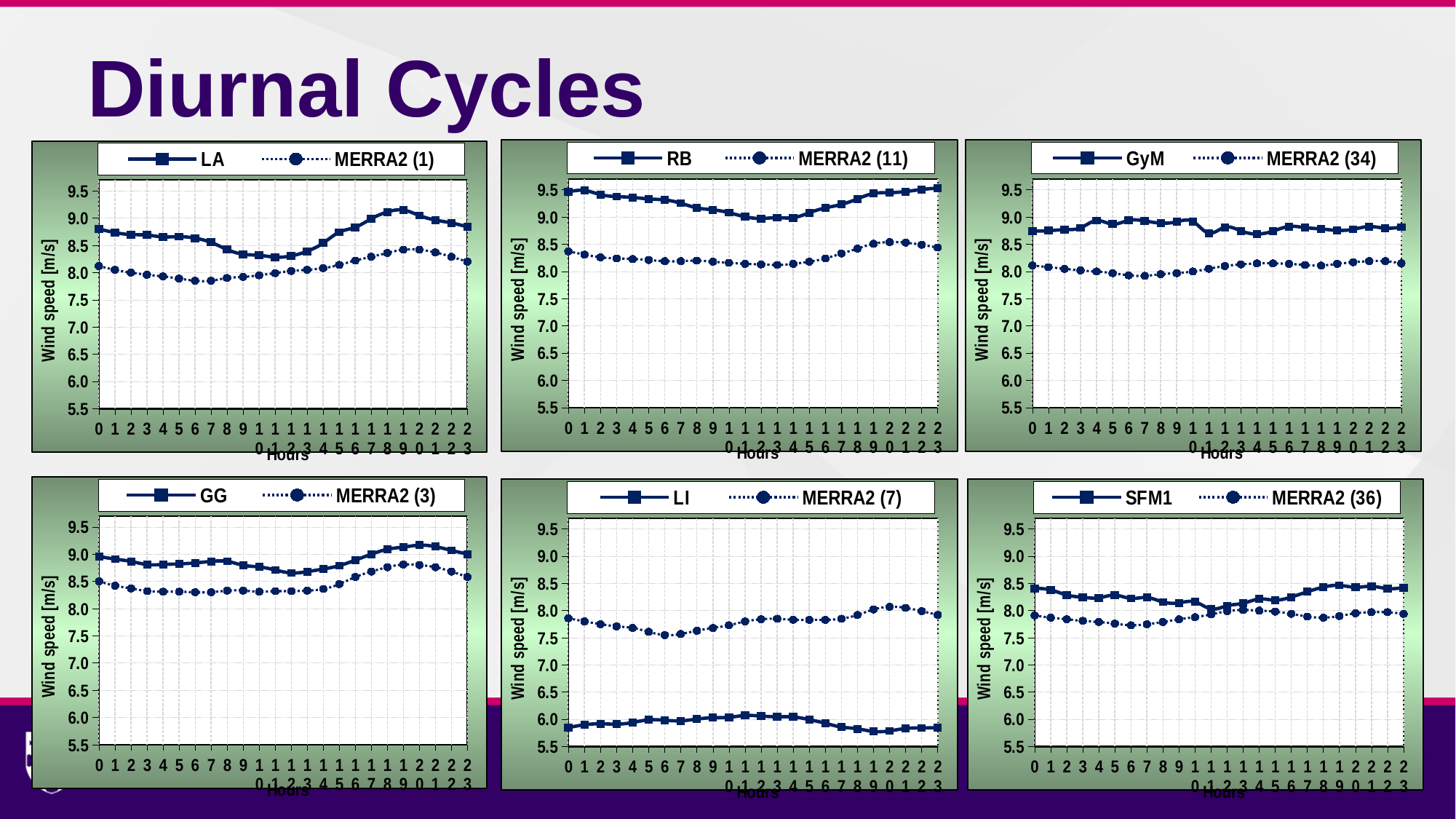
In the top-middle chart (RB), which series is higher at hour 12, RB or MERRA2 (11)? RB In the bottom-middle chart (LI), which series has the higher values across the day, LI or MERRA2 (7)? MERRA2 (7) How many series does the legend of the top-left chart (LA) list? 2 In the top-middle chart (RB), is the value for RB at hour 0 greater or less than 9.0? greater What are the two legend entries of the top-left chart? LA and MERRA2 (1) In the bottom-middle chart (LI), is the value for LI at hour 12 greater or less than 6.5? less How many hour points are plotted along the x axis of the bottom-left chart (GG)? 24 What is the y-axis label of the top-right chart (GyM)? Wind speed [m/s] What kind of chart is the top-left chart titled LA / MERRA2 (1)? Line chart In the top-middle chart (RB), does the RB series rise or fall from hour 0 to hour 12? fall In the bottom-right chart (SFM1), is the value for SFM1 at hour 0 greater or less than 8.0? greater